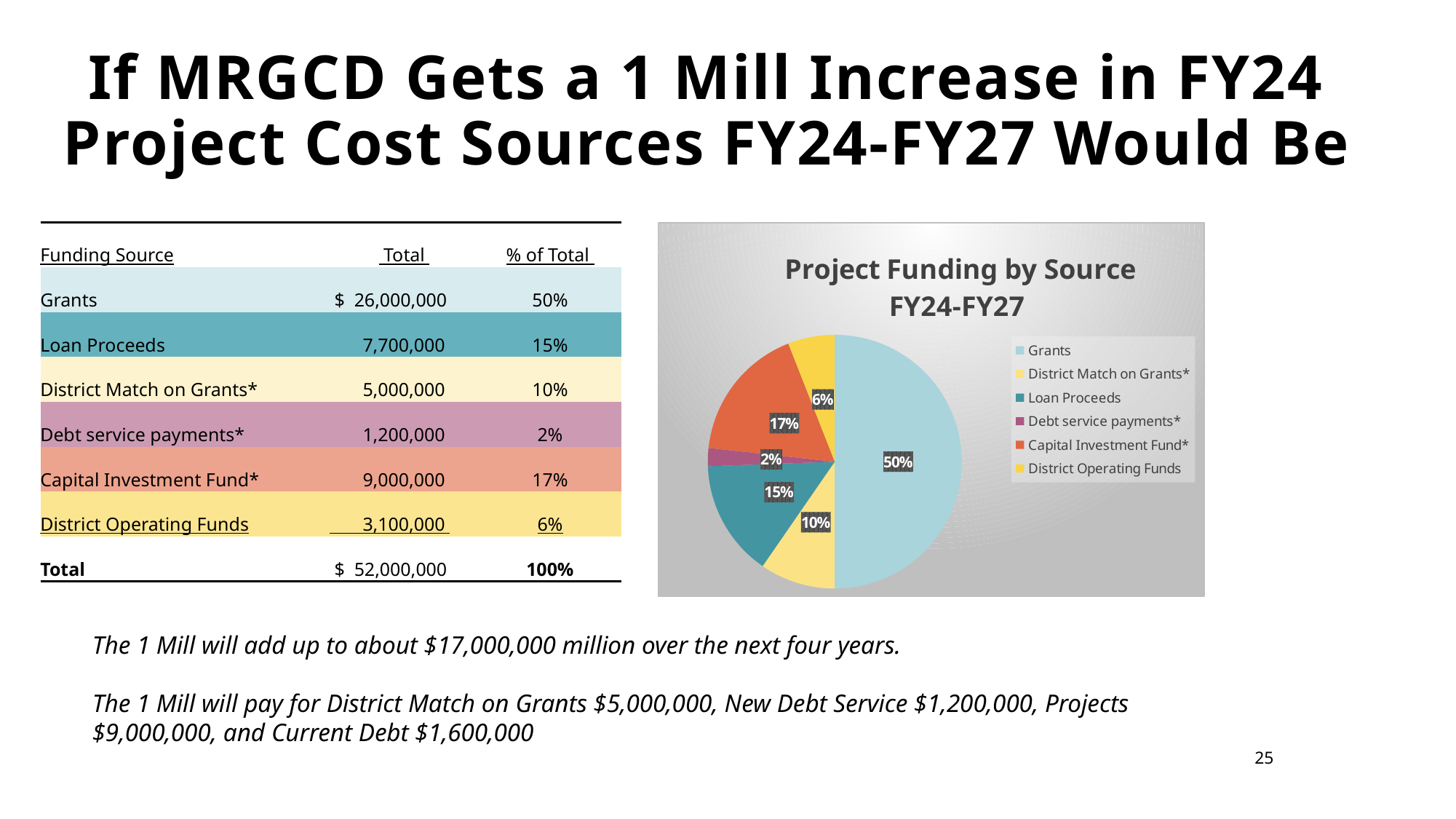
What is the title of the chart? Project Funding by Source FY24-FY27 What type of chart is shown on the slide? pie chart Which funding source has the largest slice of the pie? Grants How many entries does the chart legend list? 6 What is the difference in percentage points between the Loan Proceeds slice and the District Match on Grants* slice? 5% What share of the pie does Capital Investment Fund* represent? 17% How many slices does the pie chart have? 6 Which funding source has the smallest slice of the pie? Debt service payments* What share of the pie does District Operating Funds represent? 6% What share of the pie does Loan Proceeds represent? 15% Which slice is larger, Capital Investment Fund* or Loan Proceeds? Capital Investment Fund*